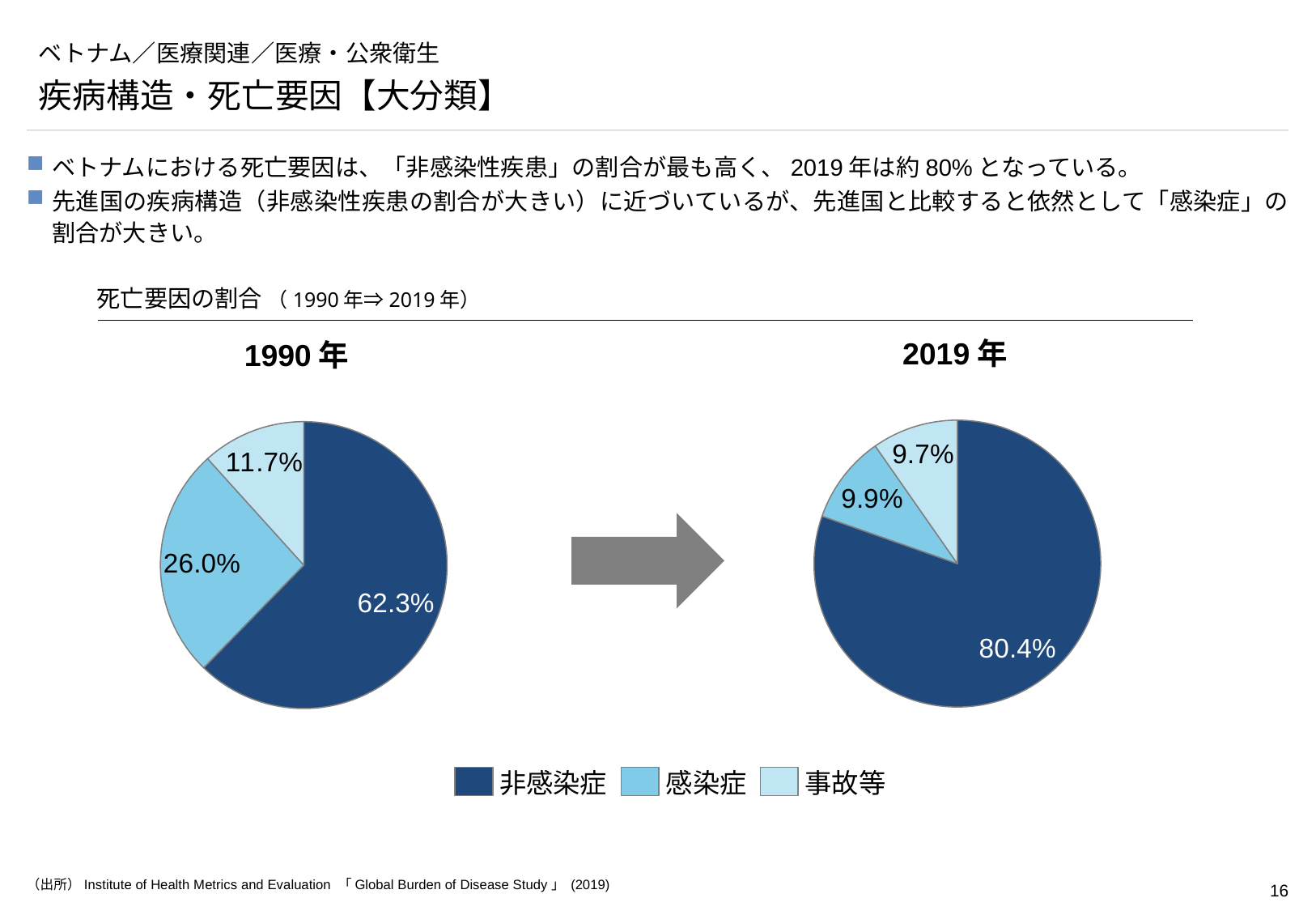
How many categories does the legend list for the pie charts? 3 What type of chart is used to show 死亡要因の割合 for 1990年 and 2019年? Pie chart What is the difference between the 非感染症 share in the 2019年 pie chart and the 非感染症 share in the 1990年 pie chart? 18.1% In the 1990年 pie chart, what is the difference between the 感染症 share and the 事故等 share? 14.3% Which is larger: the 感染症 share in the 1990年 pie chart or the 感染症 share in the 2019年 pie chart? 1990年 In the 1990年 pie chart, what share is shown for 非感染症? 62.3% In the 2019年 pie chart, what share is shown for 非感染症? 80.4% In the 2019年 pie chart, what share is shown for 事故等? 9.7% In the 1990年 pie chart, which category has the smallest slice? 事故等 In the 2019年 pie chart, which category has the largest slice? 非感染症 In the 1990年 pie chart, what share is shown for 感染症? 26.0% In the legend, which category is shown in the darkest blue? 非感染症